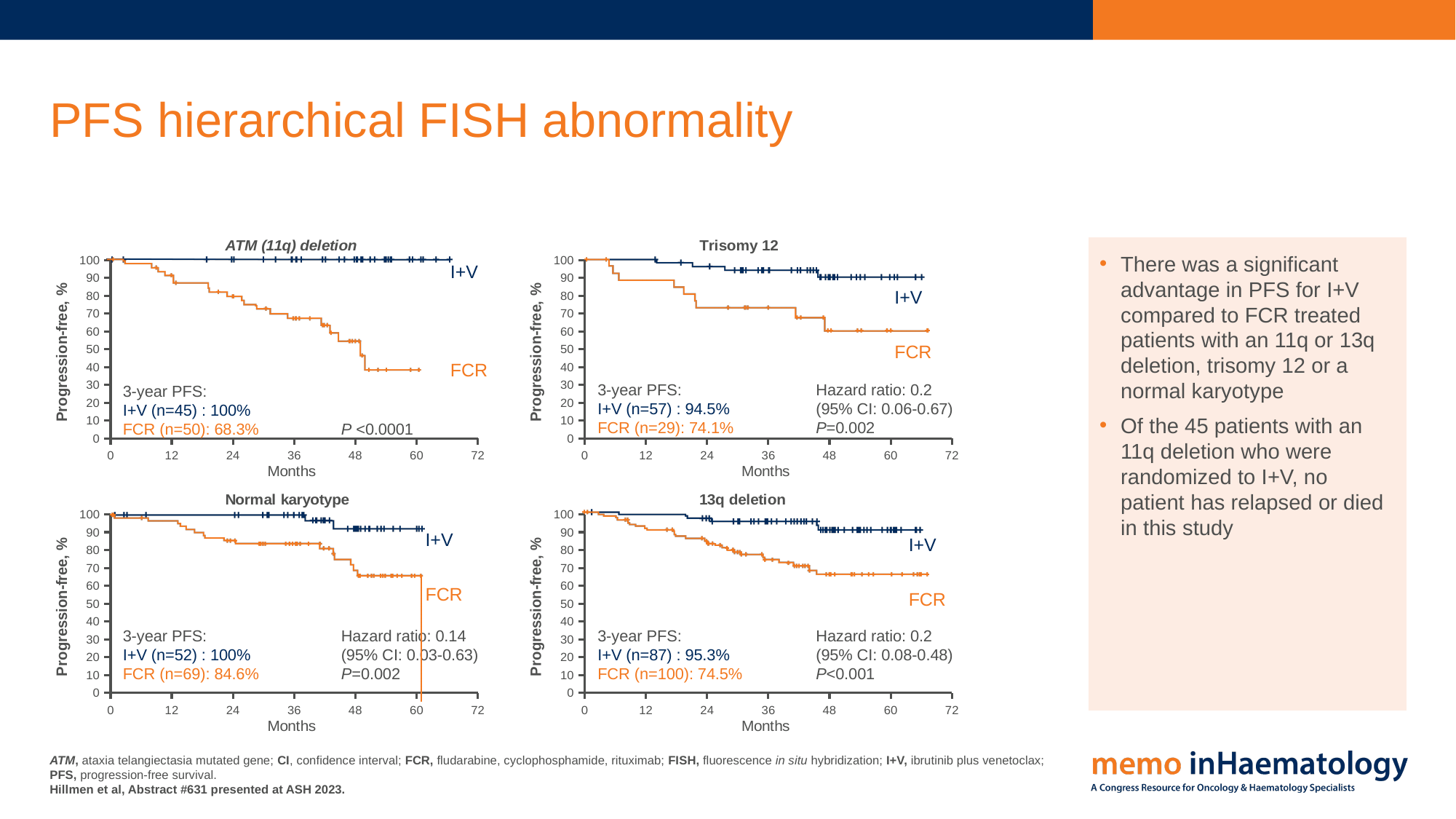
How many series (treatment groups) are plotted in the Normal karyotype chart? 2 In the Trisomy 12 chart, what is the 3-year PFS for I+V? 94.5% In the Trisomy 12 chart, which group has the higher 3-year PFS, I+V or FCR? I+V In the 13q deletion chart, how many patients are in the FCR group? 100 What kind of chart is the 13q deletion chart? Line chart (Kaplan-Meier survival curve) In the Normal karyotype chart, what hazard ratio is reported? 0.14 In the ATM (11q) deletion chart, what is the 3-year PFS for FCR? 68.3% How many charts are shown on the slide? 4 In the ATM (11q) deletion chart, does the FCR curve rise or fall as months increase? Fall In the 13q deletion chart, what is the difference in 3-year PFS between I+V and FCR? 20.8 percentage points What is the title of the top-left chart? ATM (11q) deletion In the Trisomy 12 chart, is the FCR progression-free value at 48 months greater or less than 70? less